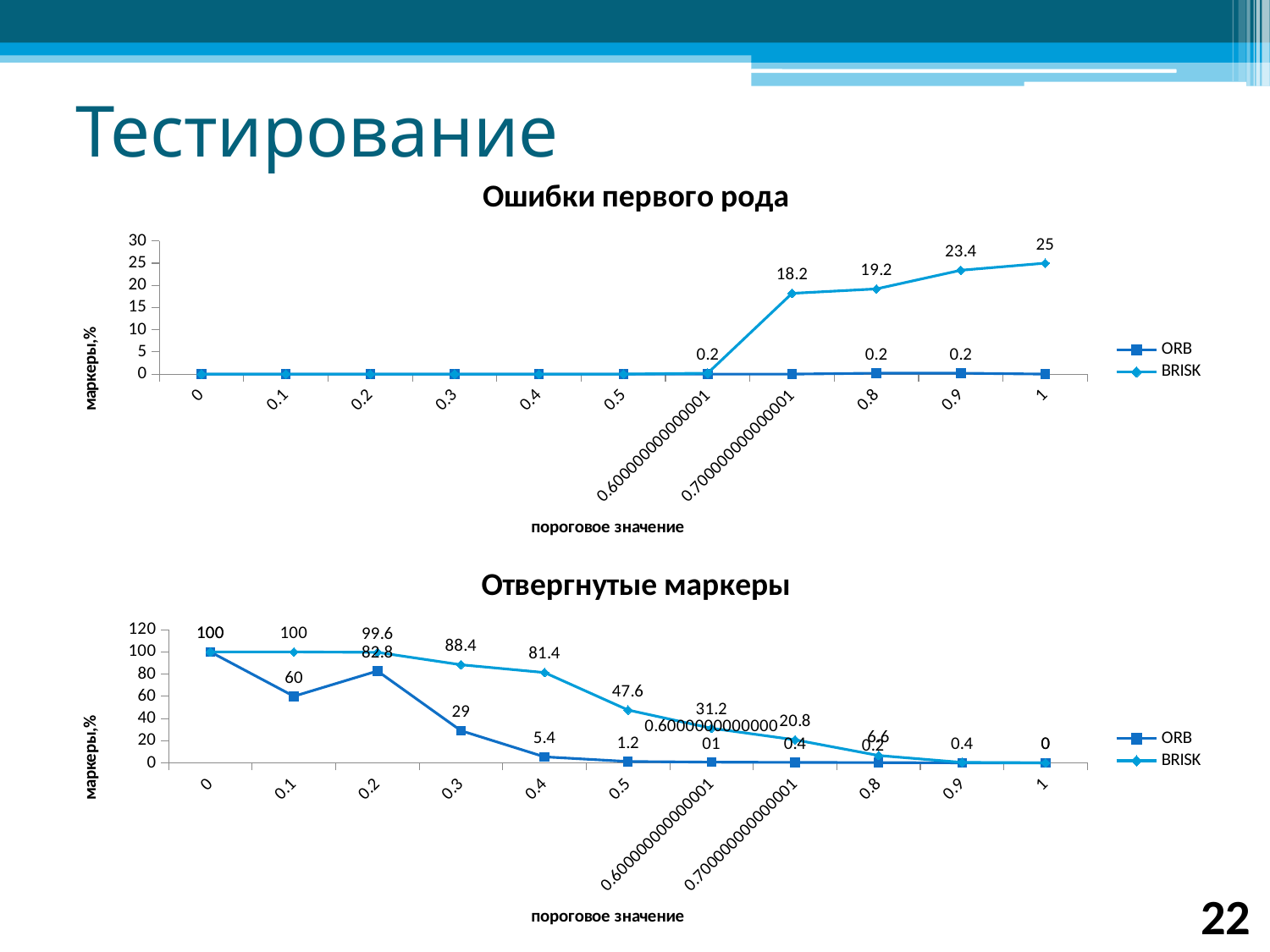
In the chart titled "Ошибки первого рода", what is the BRISK value at threshold 1? 25 What kind of chart is the chart titled "Отвергнутые маркеры"? line chart In the chart titled "Ошибки первого рода", does the BRISK line rise or fall from threshold 0.7 to threshold 1? rise In the chart titled "Отвергнутые маркеры", what is the BRISK value at threshold 0.5? 47.6 In the chart titled "Отвергнутые маркеры", does the BRISK line rise or fall as the threshold increases from 0.2 to 1? fall In the chart titled "Отвергнутые маркеры", what is the ORB value at threshold 0.1? 60 In the chart titled "Ошибки первого рода", what is the difference between the BRISK values at thresholds 0.9 and 0.8? 4.2 In the chart titled "Ошибки первого рода", how many series does the legend list? 2 In the chart titled "Ошибки первого рода", what is the BRISK value at threshold 0.9? 23.4 In the chart titled "Отвергнутые маркеры", which series has the higher value at threshold 0.4, ORB or BRISK? BRISK In the chart titled "Ошибки первого рода", which series has the higher value at threshold 1, ORB or BRISK? BRISK In the chart titled "Отвергнутые маркеры", what is the difference between the BRISK and ORB values at threshold 0.3? 59.4